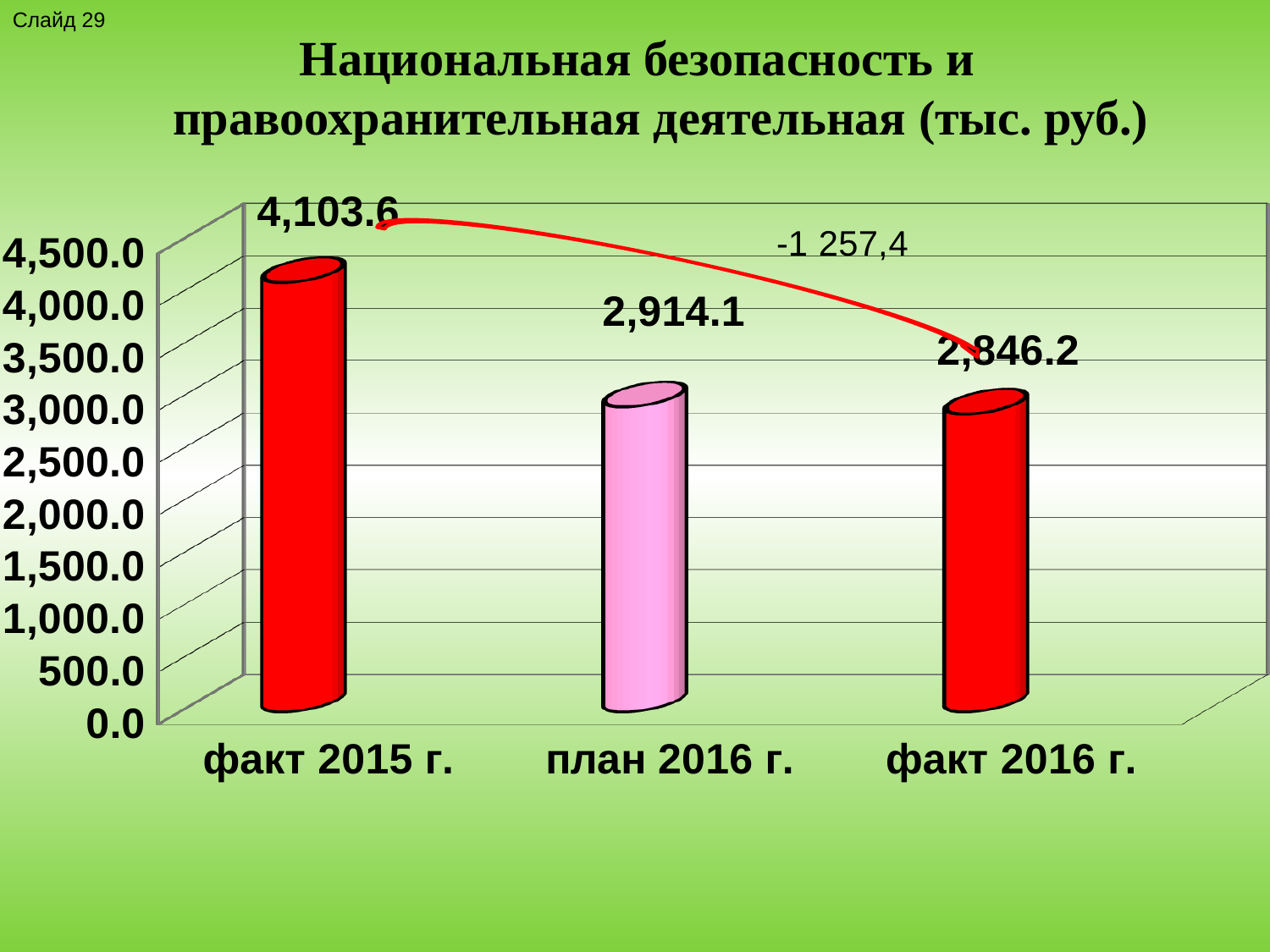
What is the value for факт 2016 г.? 2,846.2 What is the difference between the values for план 2016 г. and факт 2016 г.? 67.9 Is the value for факт 2015 г. greater or less than 4,000.0? greater Which category has the lowest value? факт 2016 г. What is the value for план 2016 г.? 2,914.1 Which category has the highest value? факт 2015 г. How many categories are shown on the x axis? 3 What change is indicated by the red arrow annotation on the chart? -1 257,4 What is the value for факт 2015 г.? 4,103.6 What is the difference between the values for факт 2015 г. and факт 2016 г.? 1,257.4 What kind of chart is shown on the slide? bar chart Which is larger, the value for план 2016 г. or the value for факт 2016 г.? план 2016 г.